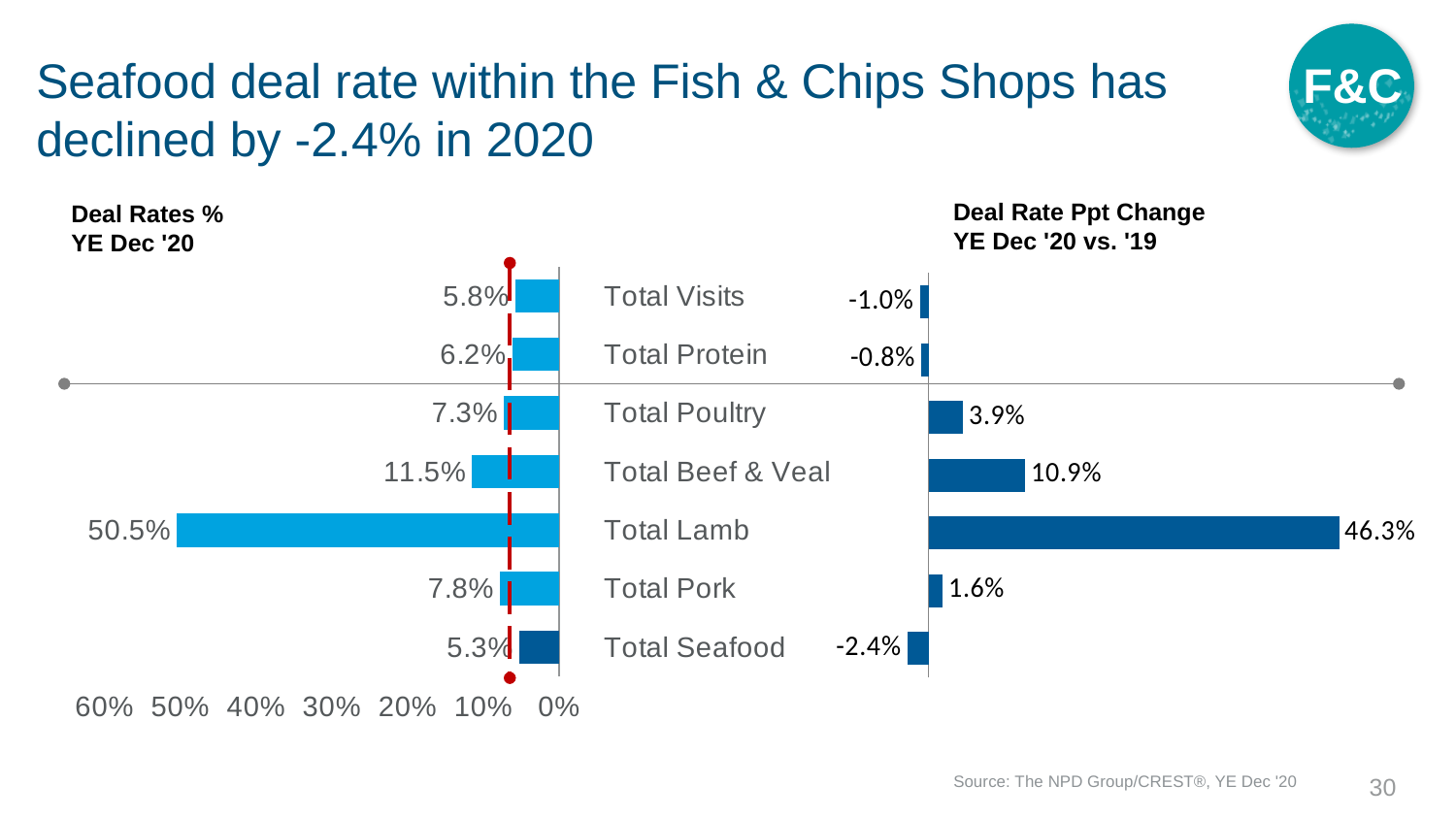
In the 'Deal Rate Ppt Change YE Dec '20 vs. '19' chart, which category has the lowest value? Total Seafood In the 'Deal Rates % YE Dec '20' chart, is the value for Total Lamb greater or less than 40%? greater In the 'Deal Rates % YE Dec '20' chart, what is the value for Total Seafood? 5.3% In the 'Deal Rate Ppt Change YE Dec '20 vs. '19' chart, what is the value for Total Beef & Veal? 10.9% In the 'Deal Rate Ppt Change YE Dec '20 vs. '19' chart, what is the value for Total Seafood? -2.4% How many categories are shown in the 'Deal Rates % YE Dec '20' chart? 7 In the 'Deal Rates % YE Dec '20' chart, which category has the lowest value? Total Seafood In the 'Deal Rates % YE Dec '20' chart, what is the difference between Total Beef & Veal and Total Poultry? 4.2% In the 'Deal Rates % YE Dec '20' chart, what is the value for Total Lamb? 50.5% What kind of chart is the 'Deal Rate Ppt Change YE Dec '20 vs. '19' chart? bar chart In the 'Deal Rates % YE Dec '20' chart, which category has the highest value? Total Lamb In the 'Deal Rate Ppt Change YE Dec '20 vs. '19' chart, which is larger, Total Poultry or Total Pork? Total Poultry